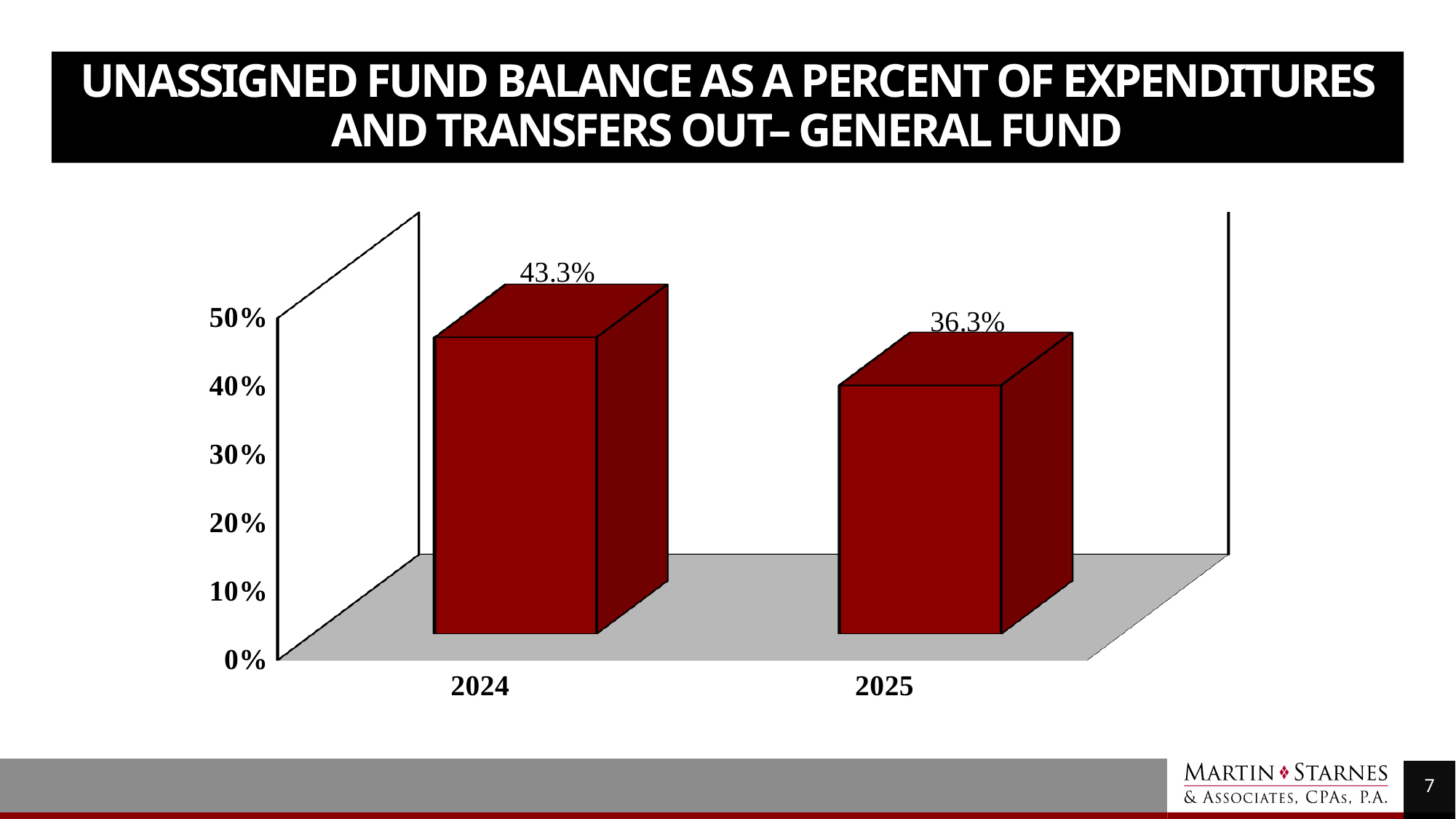
What is the unassigned fund balance as a percent of expenditures and transfers out for 2024? 43.3% Which year has the lower unassigned fund balance percentage? 2025 What is the unassigned fund balance as a percent of expenditures and transfers out for 2025? 36.3% What kind of chart is shown on the slide? bar chart Does the unassigned fund balance percentage rise or fall from 2024 to 2025? fall Is the value for 2024 larger or smaller than the value for 2025? larger Which year has the higher unassigned fund balance percentage? 2024 By how many percentage points did the unassigned fund balance percentage change from 2024 to 2025? 7.0% What is the highest value labelled on the vertical axis? 50% Is the value for 2025 greater or less than 40%? less Is the value for 2024 greater or less than 40%? greater How many years are shown on the chart? 2